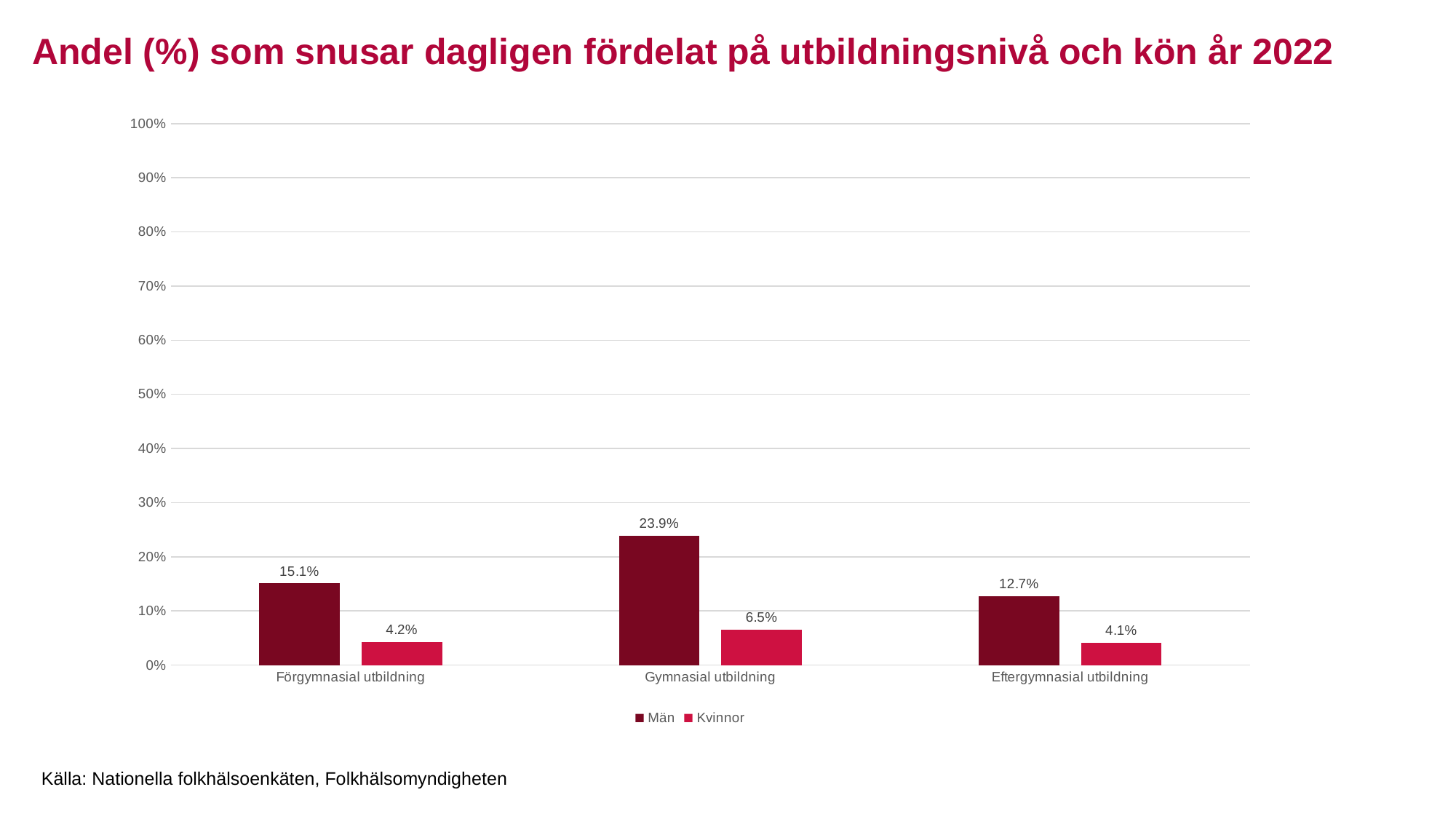
Which education level has the highest value for Kvinnor? Gymnasial utbildning How many series does the legend list? 2 What is the value for Män in the Gymnasial utbildning category? 23.9% What is the difference between the Män values for Förgymnasial utbildning and Eftergymnasial utbildning? 2.4% What is the difference between the Män and Kvinnor values for Gymnasial utbildning? 17.4% Which education level has the highest value for Män? Gymnasial utbildning How many education level categories are shown on the x axis? 3 Which education level has the lowest value for Män? Eftergymnasial utbildning What kind of chart is shown on the slide? Bar chart Which is larger: the Män value for Förgymnasial utbildning or the Män value for Eftergymnasial utbildning? Förgymnasial utbildning What is the value for Kvinnor in the Förgymnasial utbildning category? 4.2% What is the value for Kvinnor in the Eftergymnasial utbildning category? 4.1%